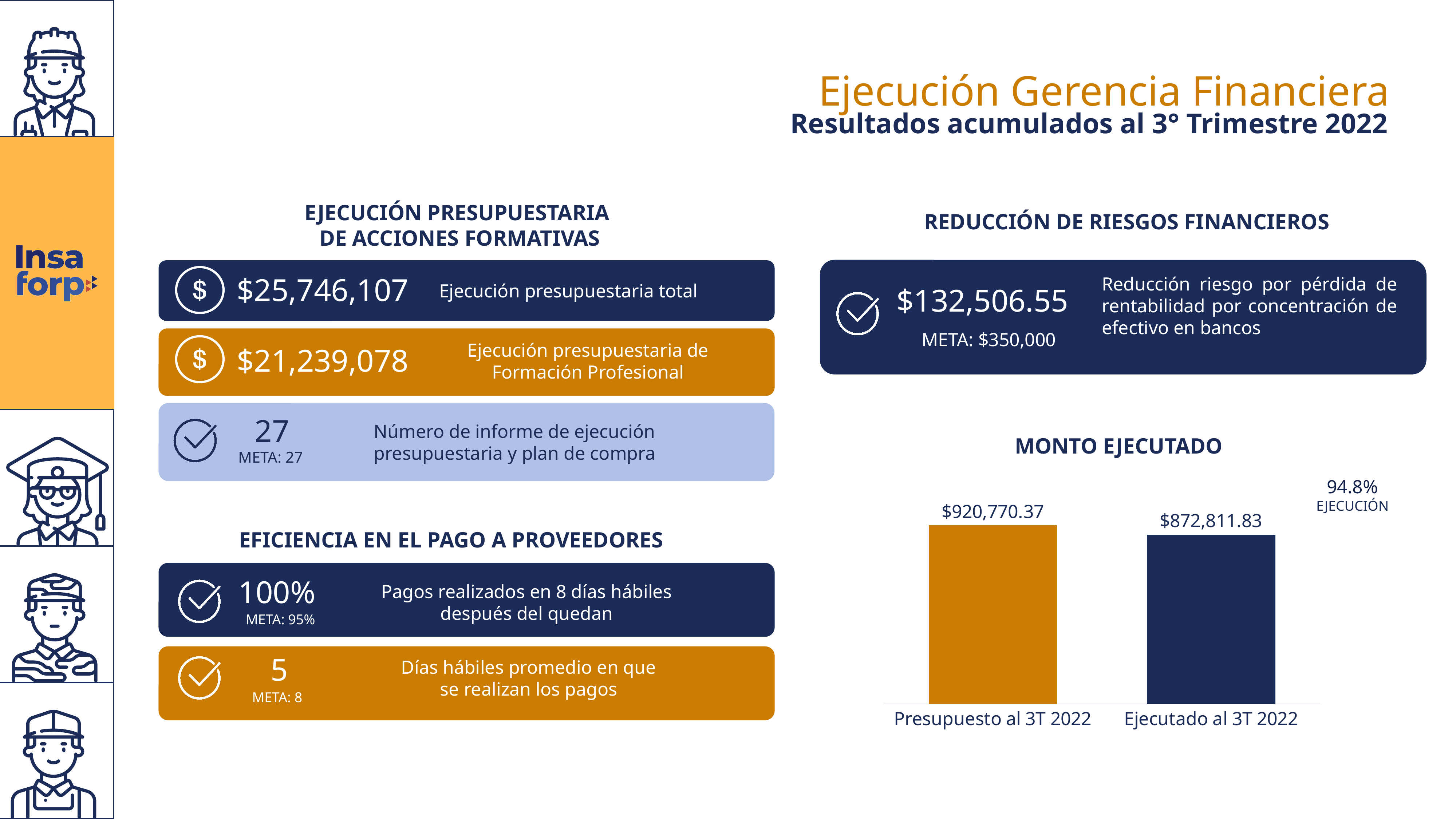
What type of chart is MONTO EJECUTADO? Bar chart In the MONTO EJECUTADO chart, what is the value for Presupuesto al 3T 2022? $920,770.37 What execution percentage (EJECUCIÓN) is annotated on the MONTO EJECUTADO chart? 94.8% How many bars are shown in the MONTO EJECUTADO chart? 2 In the MONTO EJECUTADO chart, what is the value for Ejecutado al 3T 2022? $872,811.83 In the MONTO EJECUTADO chart, which is larger: Presupuesto al 3T 2022 or Ejecutado al 3T 2022? Presupuesto al 3T 2022 In the MONTO EJECUTADO chart, what is the difference between Presupuesto al 3T 2022 and Ejecutado al 3T 2022? $47,958.54 In the MONTO EJECUTADO chart, which category has the lowest value? Ejecutado al 3T 2022 In the MONTO EJECUTADO chart, do the values rise or fall from Presupuesto al 3T 2022 to Ejecutado al 3T 2022? Fall What is the title of the bar chart on the slide? MONTO EJECUTADO In the MONTO EJECUTADO chart, which category has the highest value? Presupuesto al 3T 2022